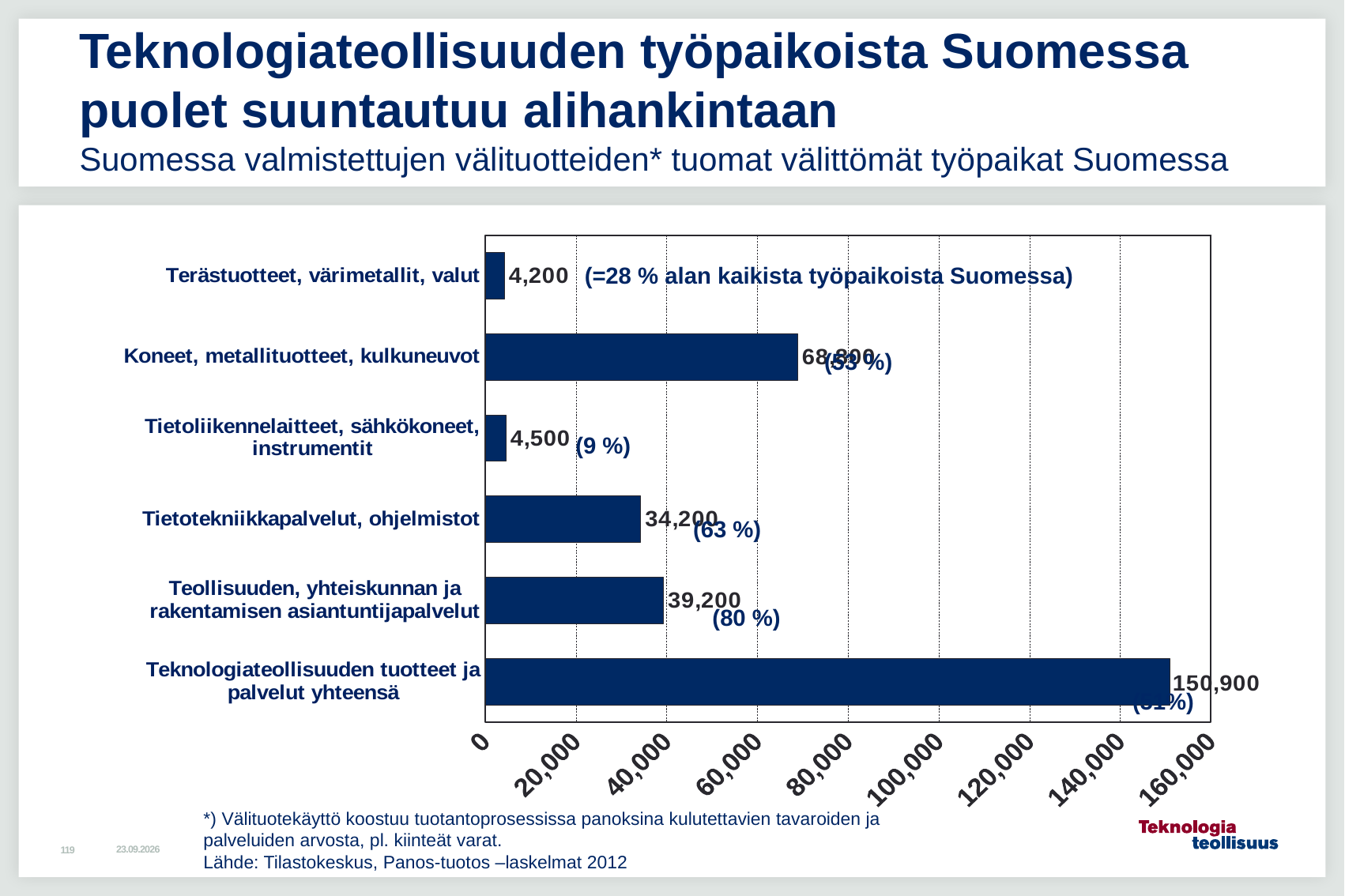
Which category has the highest value? Teknologiateollisuuden tuotteet ja palvelut yhteensä How many categories are plotted in the chart? 6 Is the value for Koneet, metallituotteet, kulkuneuvot greater or less than 60,000? greater What percentage of all jobs in the sector in Finland does the Terästuotteet, värimetallit, valut bar represent, according to the label next to it? 28 % What is the value for Tietotekniikkapalvelut, ohjelmistot? 34,200 What is the value for Terästuotteet, värimetallit, valut? 4,200 What is the value for Teollisuuden, yhteiskunnan ja rakentamisen asiantuntijapalvelut? 39,200 Which category has the lowest value? Terästuotteet, värimetallit, valut What kind of chart is shown on the slide? bar chart What is the value for Tietoliikennelaitteet, sähkökoneet, instrumentit? 4,500 What is the value for Teknologiateollisuuden tuotteet ja palvelut yhteensä? 150,900 What is the difference between the values for Teollisuuden, yhteiskunnan ja rakentamisen asiantuntijapalvelut and Tietotekniikkapalvelut, ohjelmistot? 5,000